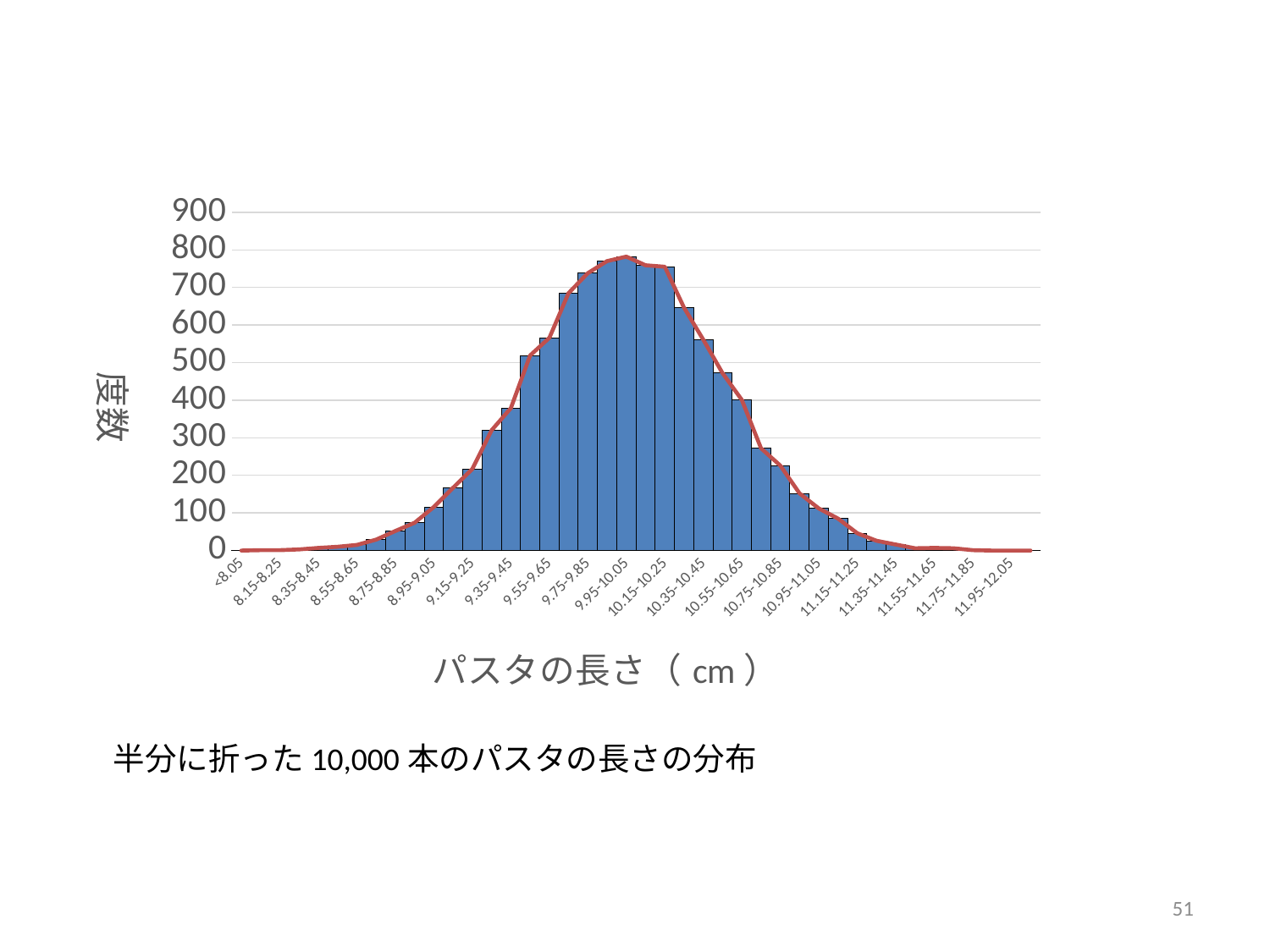
Do the values rise or fall along the x axis from 8.15-8.25 to 9.95-10.05? rise What kind of chart is shown on the slide? combination bar and line chart Is the value for 10.75-10.85 greater or less than 400? less Is the value for 8.15-8.25 greater or less than 100? less Is the value for 9.55-9.65 greater or less than 400? greater What is the title of the x axis? パスタの長さ（ cm ） Which has the larger value, 9.55-9.65 or 10.75-10.85? 9.55-9.65 Which has the larger value, 9.35-9.45 or 10.95-11.05? 9.35-9.45 Do the values rise or fall along the x axis from 9.95-10.05 to 11.95-12.05? fall